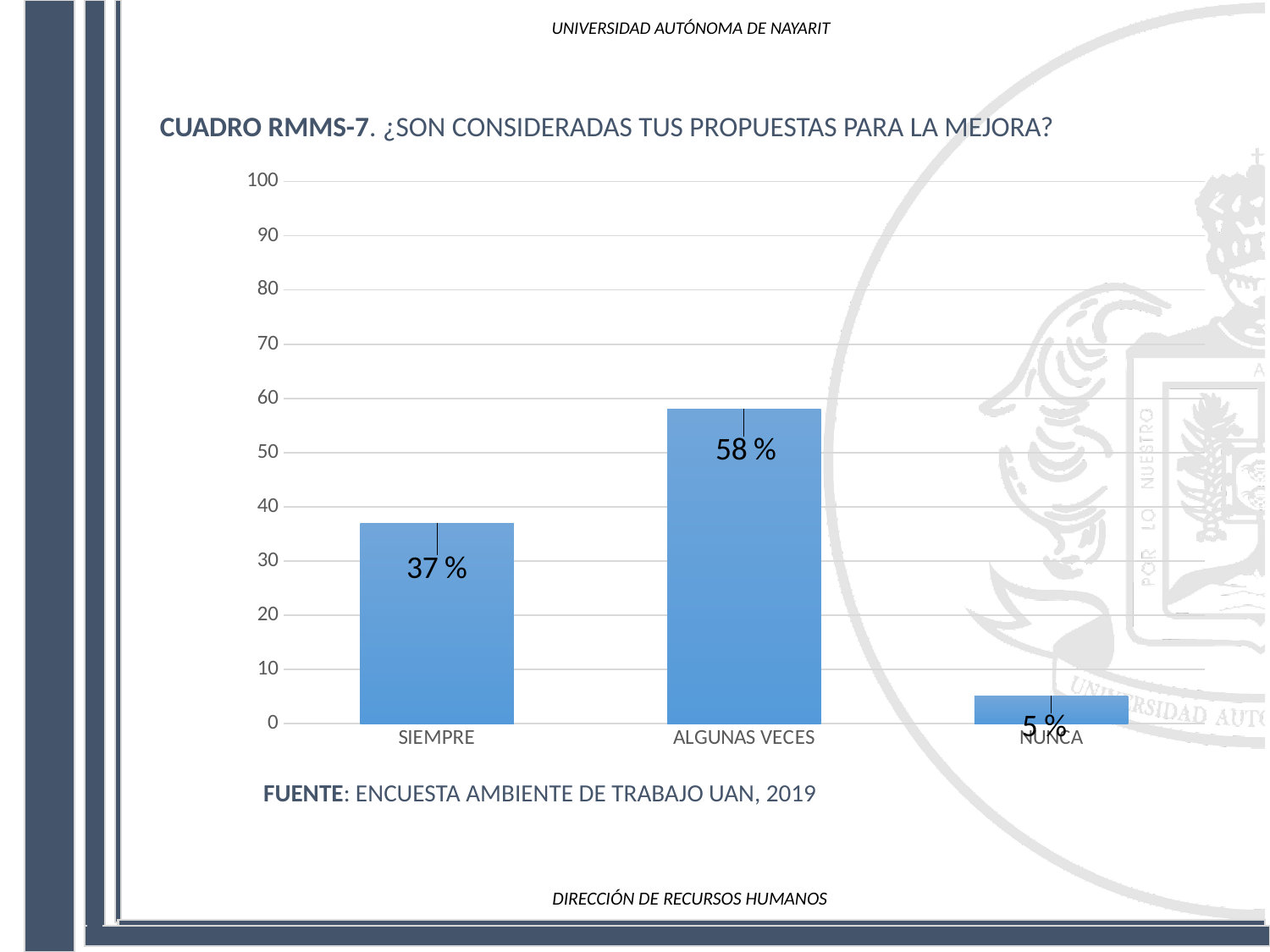
How many categories are shown on the x axis? 3 Which category has the highest value? ALGUNAS VECES What is the source cited below the chart? ENCUESTA AMBIENTE DE TRABAJO UAN, 2019 What is the difference between the values for ALGUNAS VECES and SIEMPRE? 21 % Is the value for ALGUNAS VECES greater or less than 50? greater What is the maximum value shown on the y axis? 100 What is the value for ALGUNAS VECES? 58 % What is the value for NUNCA? 5 % Which is larger, the value for SIEMPRE or the value for NUNCA? SIEMPRE What kind of chart is shown on the slide? bar chart Which category has the lowest value? NUNCA What is the value for SIEMPRE? 37 %